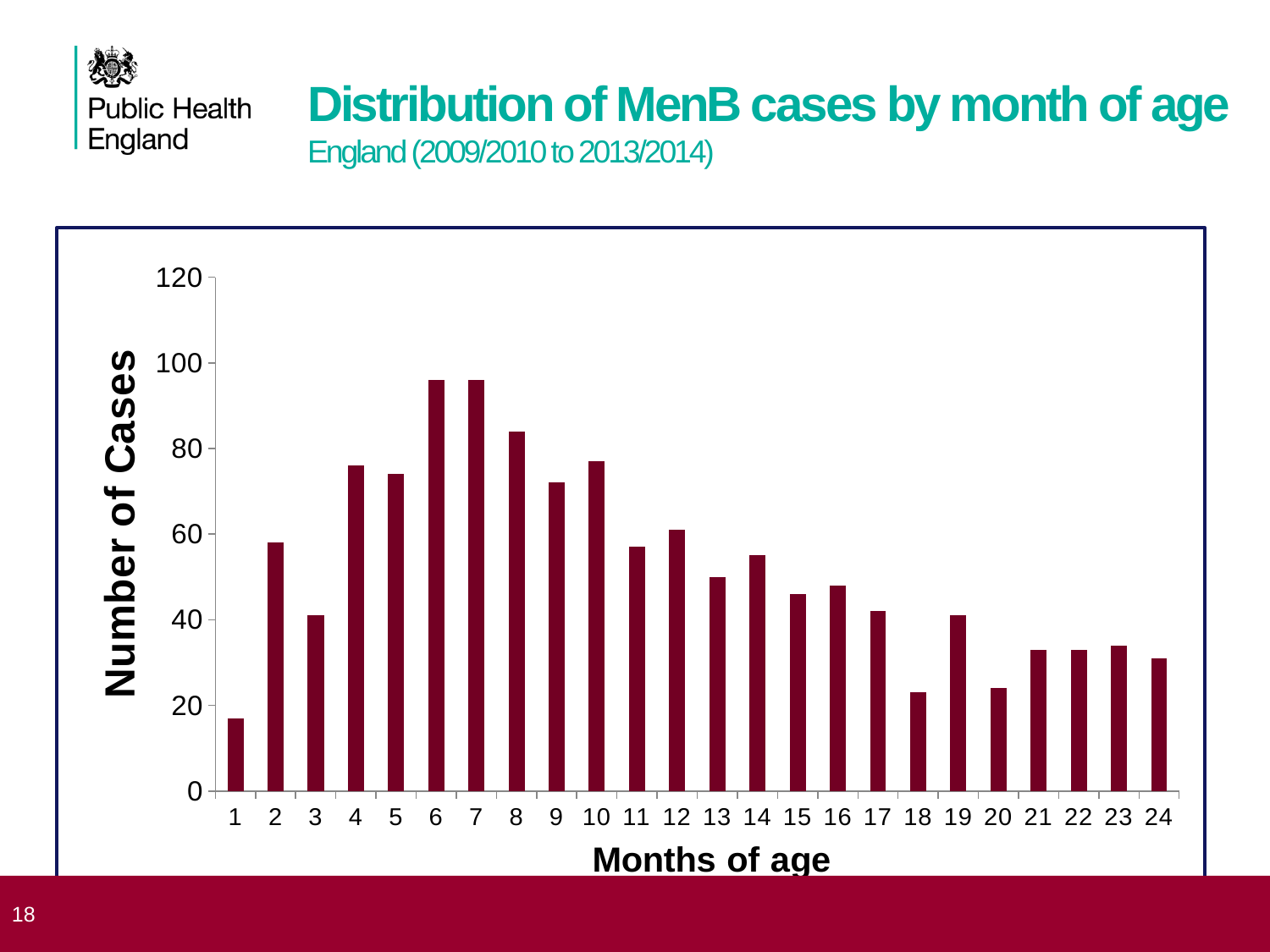
Is the number of cases at 15 months of age greater or less than 60? less Which has more cases, 18 months of age or 19 months of age? 19 months of age Is the number of cases at 24 months of age greater or less than 40? less What type of chart is shown on the slide? bar chart Is the number of cases at 6 months of age greater or less than 80? greater Do the number of cases generally rise or fall from 7 months of age to 24 months of age? fall Which month of age has the lowest number of cases? 1 How many months of age are plotted on the x axis? 24 Which has more cases, 2 months of age or 3 months of age? 2 months of age What is the label on the y axis of the chart? Number of Cases